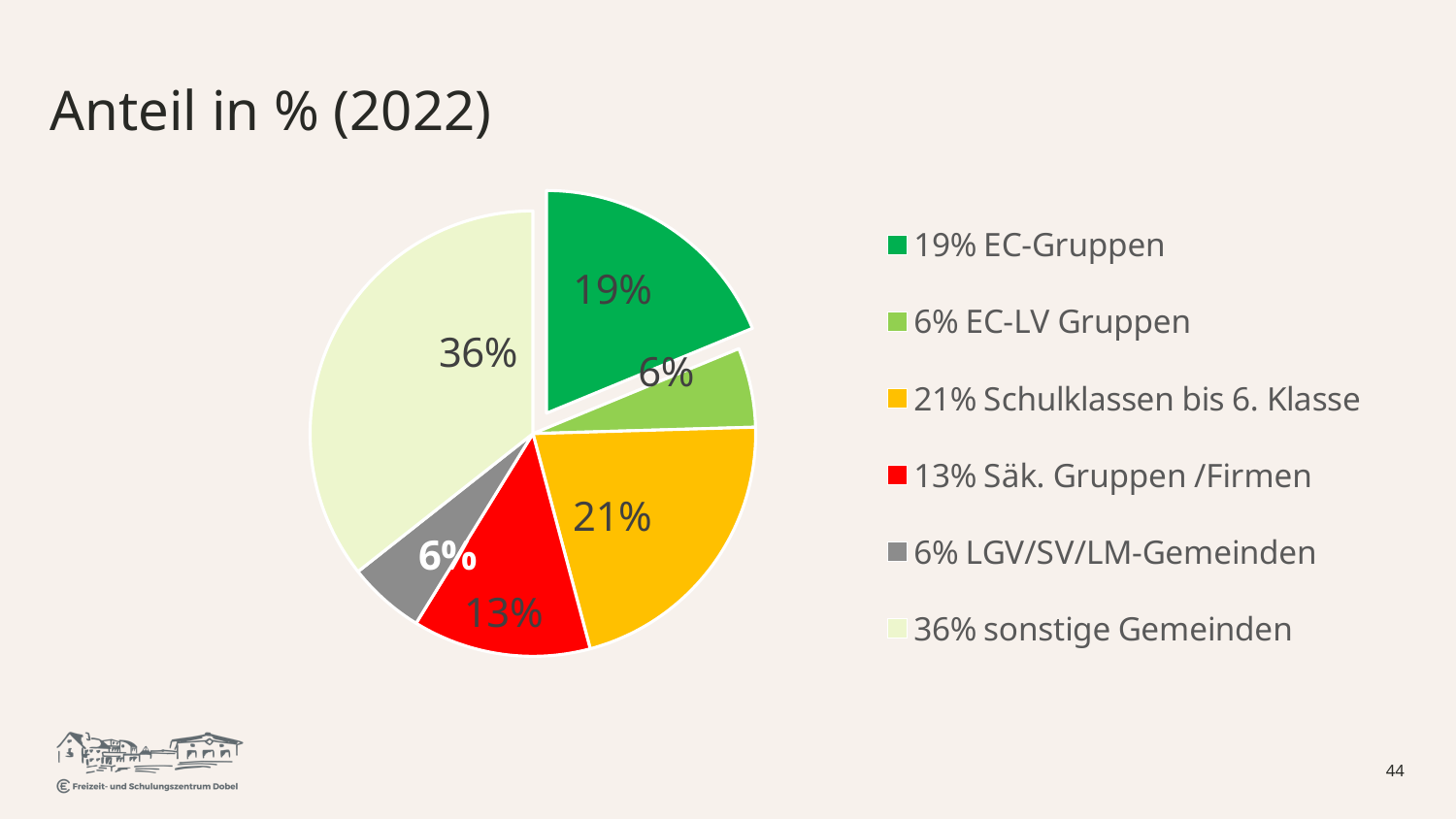
What share of the pie is Säk. Gruppen /Firmen? 13% How many entries does the legend list? 6 Which is larger, the share of EC-Gruppen or the share of Säk. Gruppen /Firmen? EC-Gruppen How many slices does the pie chart have? 6 What share of the pie is Schulklassen bis 6. Klasse? 21% What colour is the slice for Säk. Gruppen /Firmen? red What share of the pie is EC-Gruppen? 19% Which category has the largest share of the pie? sonstige Gemeinden What share of the pie is sonstige Gemeinden? 36% What is the difference between the shares of sonstige Gemeinden and Schulklassen bis 6. Klasse? 15% What kind of chart is shown on the slide? pie chart What is the title of the chart? Anteil in % (2022)